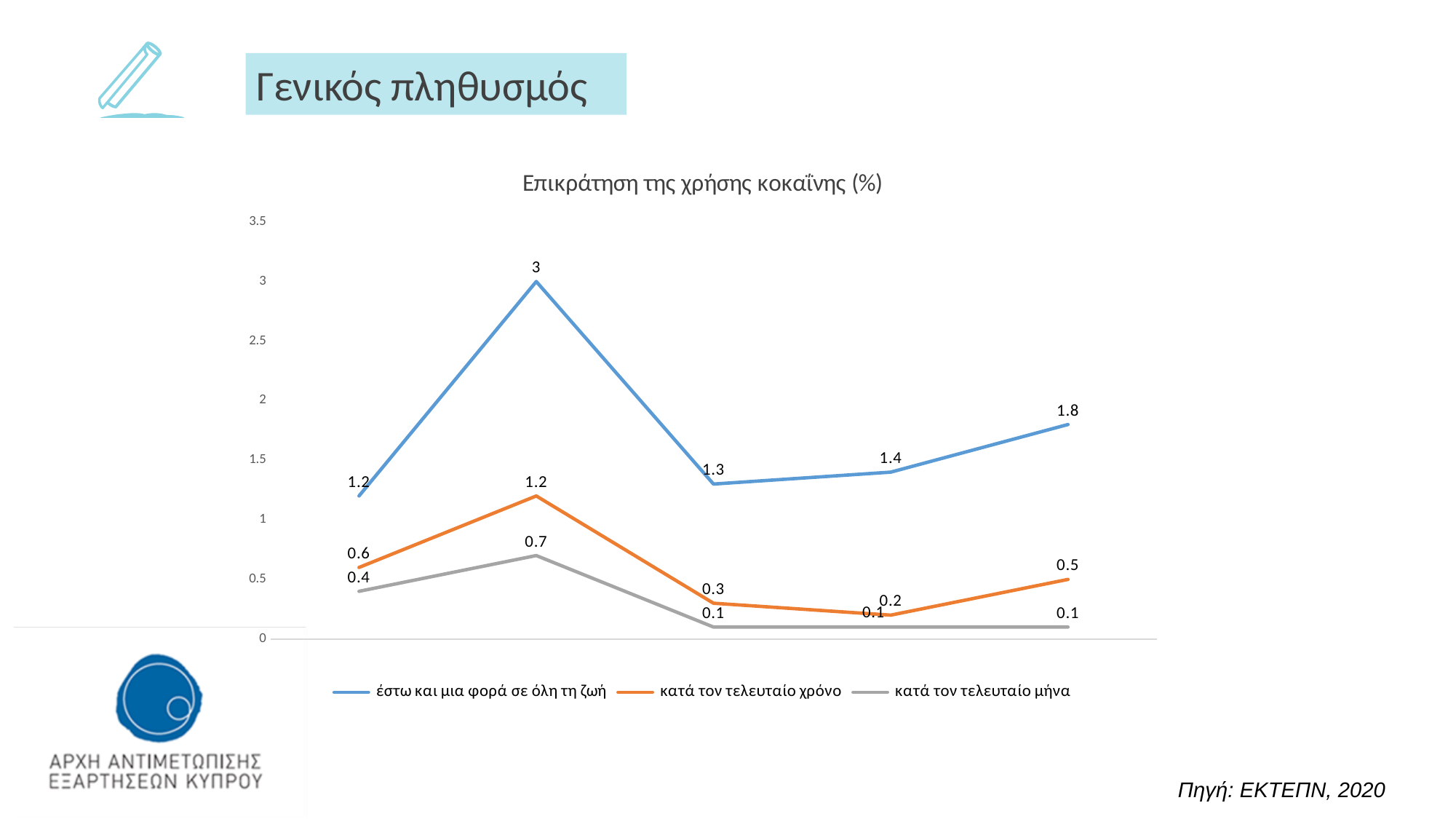
How many data points does each line have? 5 What is the highest value of the series 'κατά τον τελευταίο χρόνο'? 1.2 Which series has the highest peak value: 'κατά τον τελευταίο χρόνο' or 'κατά τον τελευταίο μήνα'? κατά τον τελευταίο χρόνο What is the highest value of the series 'έστω και μια φορά σε όλη τη ζωή'? 3 What is the lowest value of the series 'κατά τον τελευταίο χρόνο'? 0.2 What is the value of the last point of the series 'έστω και μια φορά σε όλη τη ζωή'? 1.8 What is the highest value of the series 'κατά τον τελευταίο μήνα'? 0.7 What is the title of the chart? Επικράτηση της χρήσης κοκαΐνης (%) What is the difference between the highest and lowest values of the series 'έστω και μια φορά σε όλη τη ζωή'? 1.8 What kind of chart is shown on the slide? line chart What colour is the line for 'κατά τον τελευταίο μήνα'? gray How many series does the legend list? 3